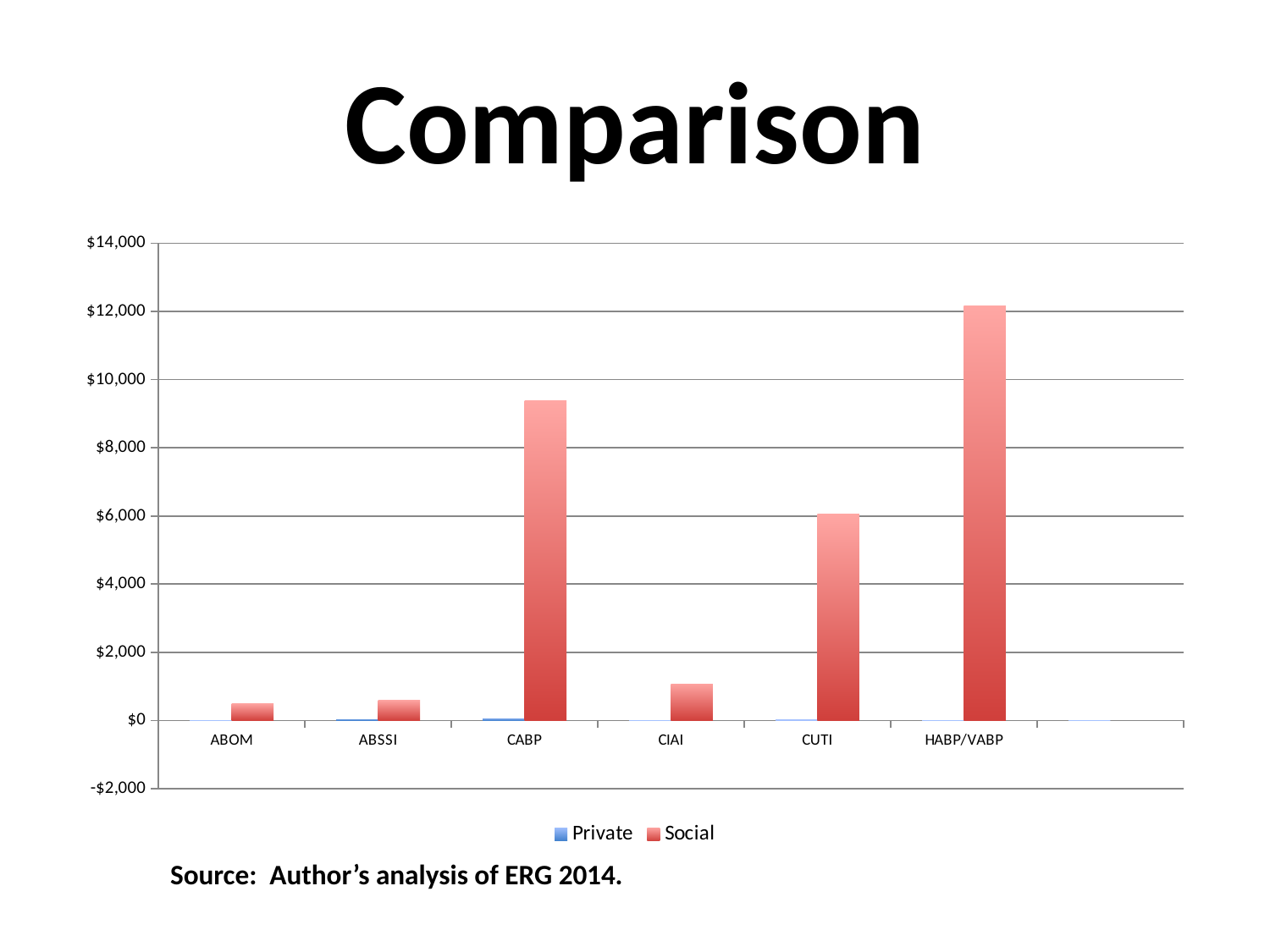
Is the Social value for CABP greater or less than $8,000? greater Which has the larger Social value, CABP or CUTI? CABP How many categories are shown on the x axis of the chart? 6 How many series does the chart's legend list? 2 What are the two series named in the chart's legend? Private and Social Is the Social value for CIAI greater or less than $2,000? less What kind of chart is shown on the slide? bar chart What is the title of the chart on the slide? Comparison Which category has the highest Social value? HABP/VABP Is the Social value for CUTI greater or less than $4,000? greater Which has the larger Social value, CIAI or ABSSI? CIAI